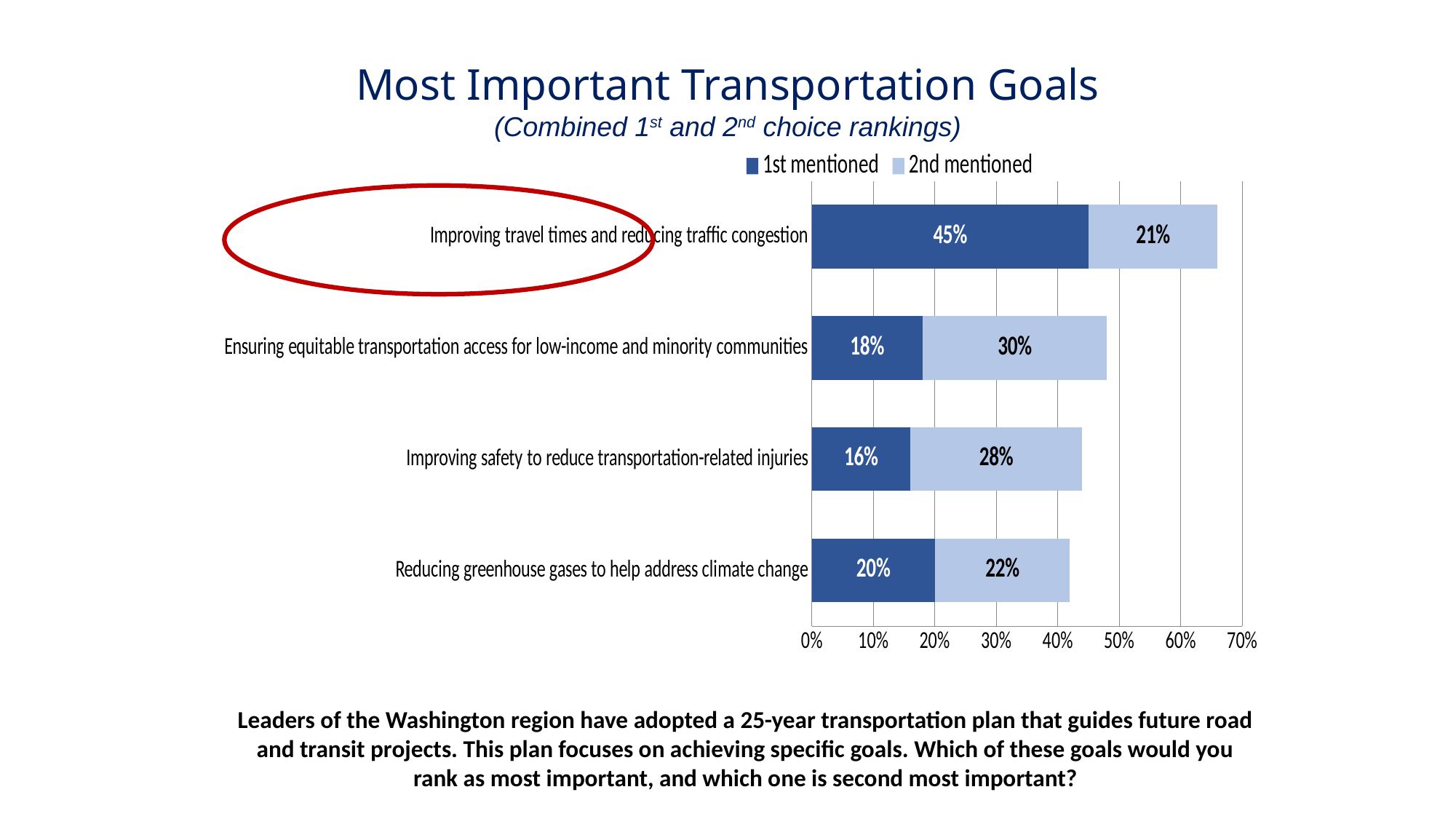
What is the '2nd mentioned' value for 'Ensuring equitable transportation access for low-income and minority communities'? 30% What is the '1st mentioned' value for 'Reducing greenhouse gases to help address climate change'? 20% What percentage of respondents mentioned 'Improving travel times and reducing traffic congestion' as their 1st choice? 45% What type of chart is shown on the slide? Stacked bar chart How many transportation goals are shown in the chart? 4 Which is larger: the '2nd mentioned' value for 'Improving safety to reduce transportation-related injuries' or for 'Reducing greenhouse gases to help address climate change'? Improving safety to reduce transportation-related injuries Which goal has the lowest '1st mentioned' percentage? Improving safety to reduce transportation-related injuries Which goal has the highest '1st mentioned' percentage? Improving travel times and reducing traffic congestion What is the difference between the '1st mentioned' values for 'Improving travel times and reducing traffic congestion' and 'Ensuring equitable transportation access for low-income and minority communities'? 27% How many series does the legend list? 2 What is the combined total (1st and 2nd mentioned) for 'Improving safety to reduce transportation-related injuries'? 44% What is the combined total (1st and 2nd mentioned) for 'Improving travel times and reducing traffic congestion'? 66%